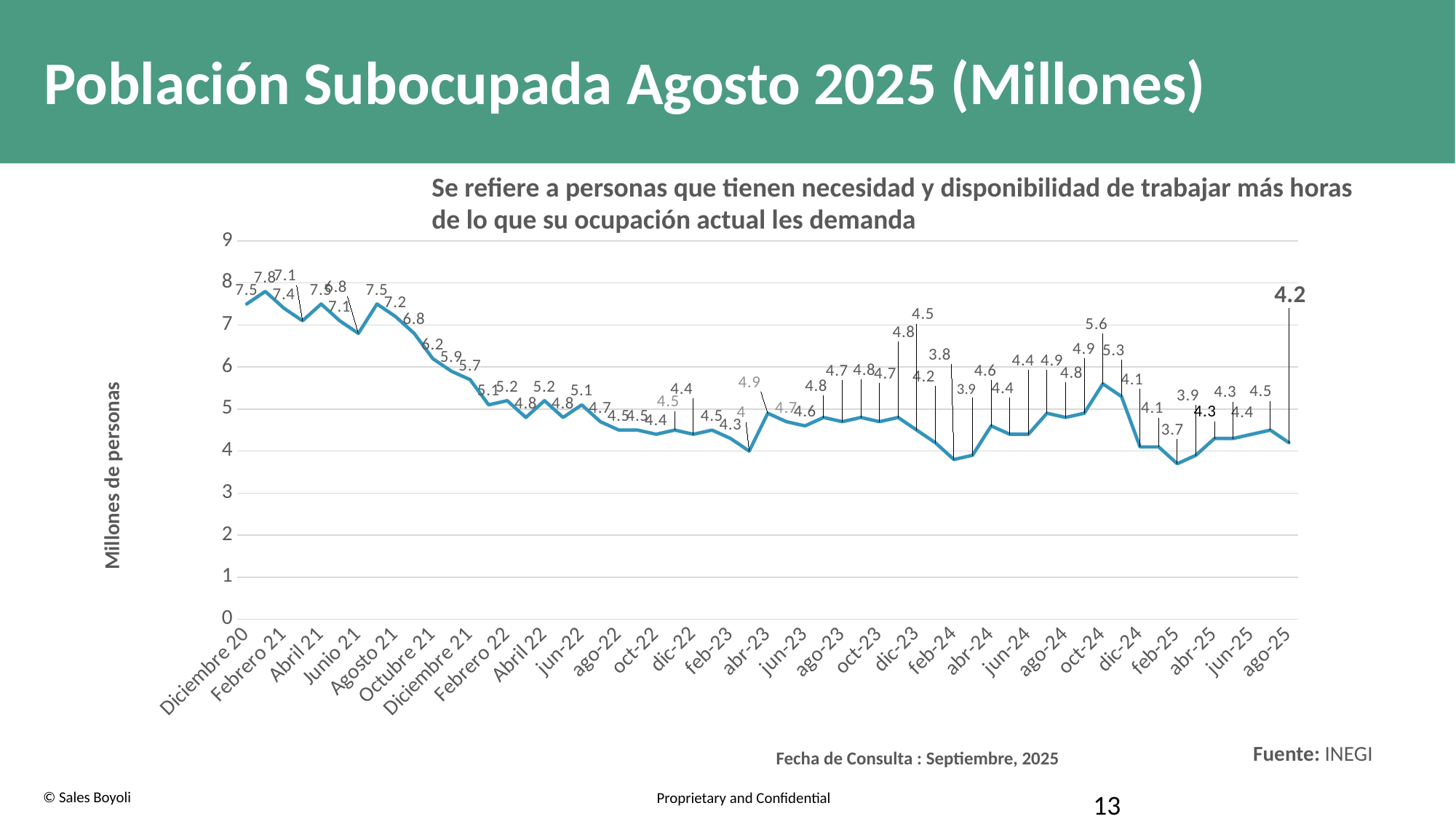
What is the value for Octubre 21? 6.2 What is the value for ago-25? 4.2 What is the difference between the value for oct-24 and the value for ago-25? 1.4 What is the lowest value plotted on the chart? 3.7 Which is larger, the value for Diciembre 20 or the value for ago-25? Diciembre 20 What is the value for Diciembre 20? 7.5 What is the value for oct-24? 5.6 Overall, do the values rise or fall from Diciembre 20 to ago-25? fall What is the highest value plotted on the chart? 7.8 What kind of chart is shown on the slide? line chart What is the label of the vertical axis? Millones de personas What is the value for feb-25? 3.7